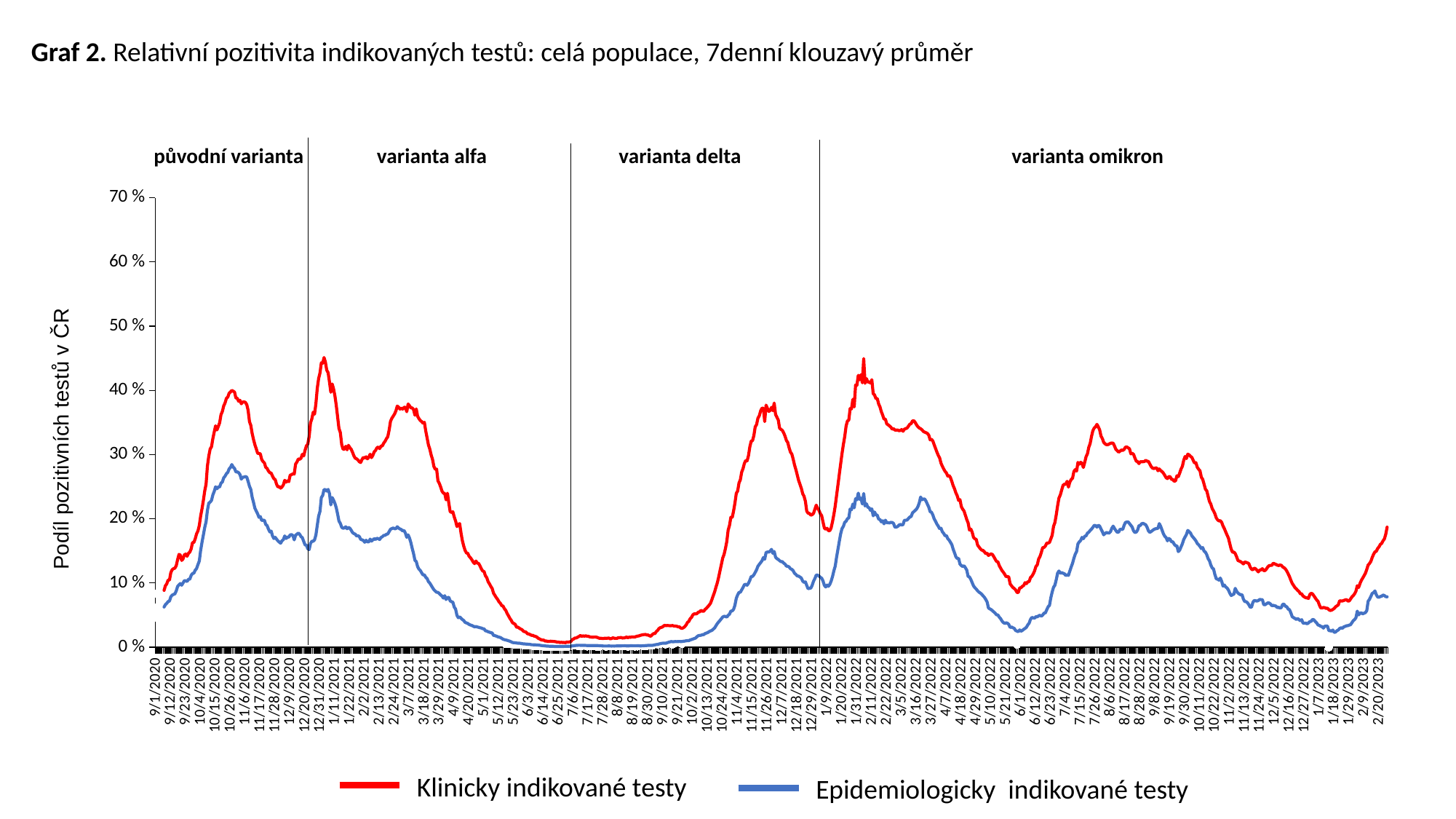
Is the peak of the Klinicky indikované testy line in the 'varianta alfa' period greater or less than 40 %? greater Is the peak of the Epidemiologicky indikované testy line in the 'varianta alfa' period greater or less than 30 %? less What are the two series named in the legend? Klinicky indikované testy; Epidemiologicky indikované testy Is the highest peak of the Klinicky indikované testy line in the 'varianta omikron' period greater or less than 40 %? greater What kind of chart is shown on the slide? line chart Between 3/7/2021 and 6/14/2021, does the Klinicky indikované testy line rise or fall? fall How many series does the legend list? 2 How many variant periods are labelled above the chart? 4 Which series is drawn in red? Klinicky indikované testy Which series generally has the higher values across the chart, Klinicky indikované testy or Epidemiologicky indikované testy? Klinicky indikované testy